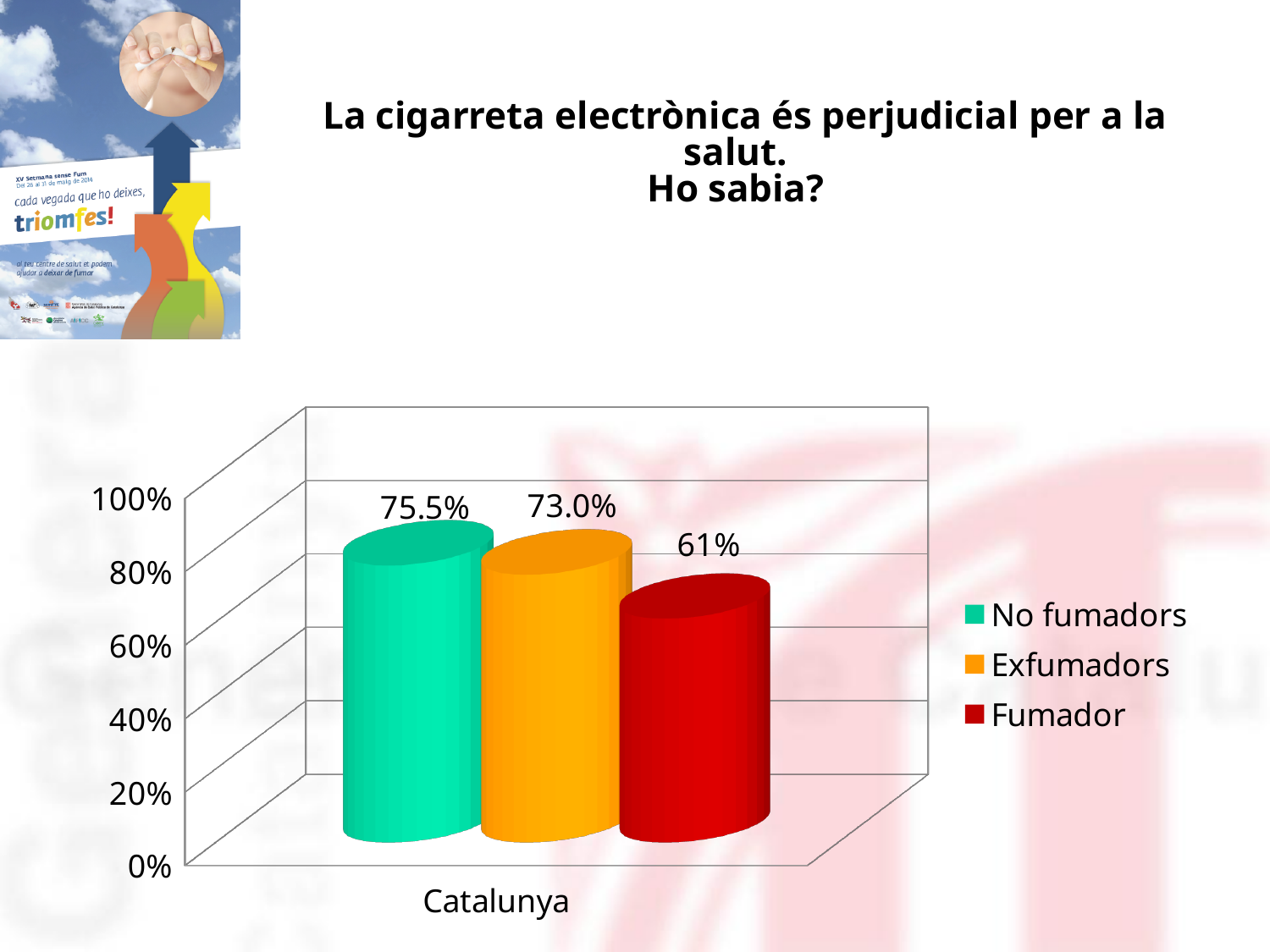
What is the value for Exfumadors in Catalunya? 73.0% What kind of chart is shown on the slide? bar chart What is the value for Fumador in Catalunya? 61% Which is larger, the value for Exfumadors or the value for Fumador? Exfumadors What is the difference between the Exfumadors and Fumador values? 12.0% How many series does the legend list? 3 What is the category label on the x axis of the chart? Catalunya What is the value for No fumadors in Catalunya? 75.5% Which series has the highest value? No fumadors What is the difference between the No fumadors and Fumador values? 14.5% Is the value for Fumador greater or less than 80%? less Which series has the lowest value? Fumador